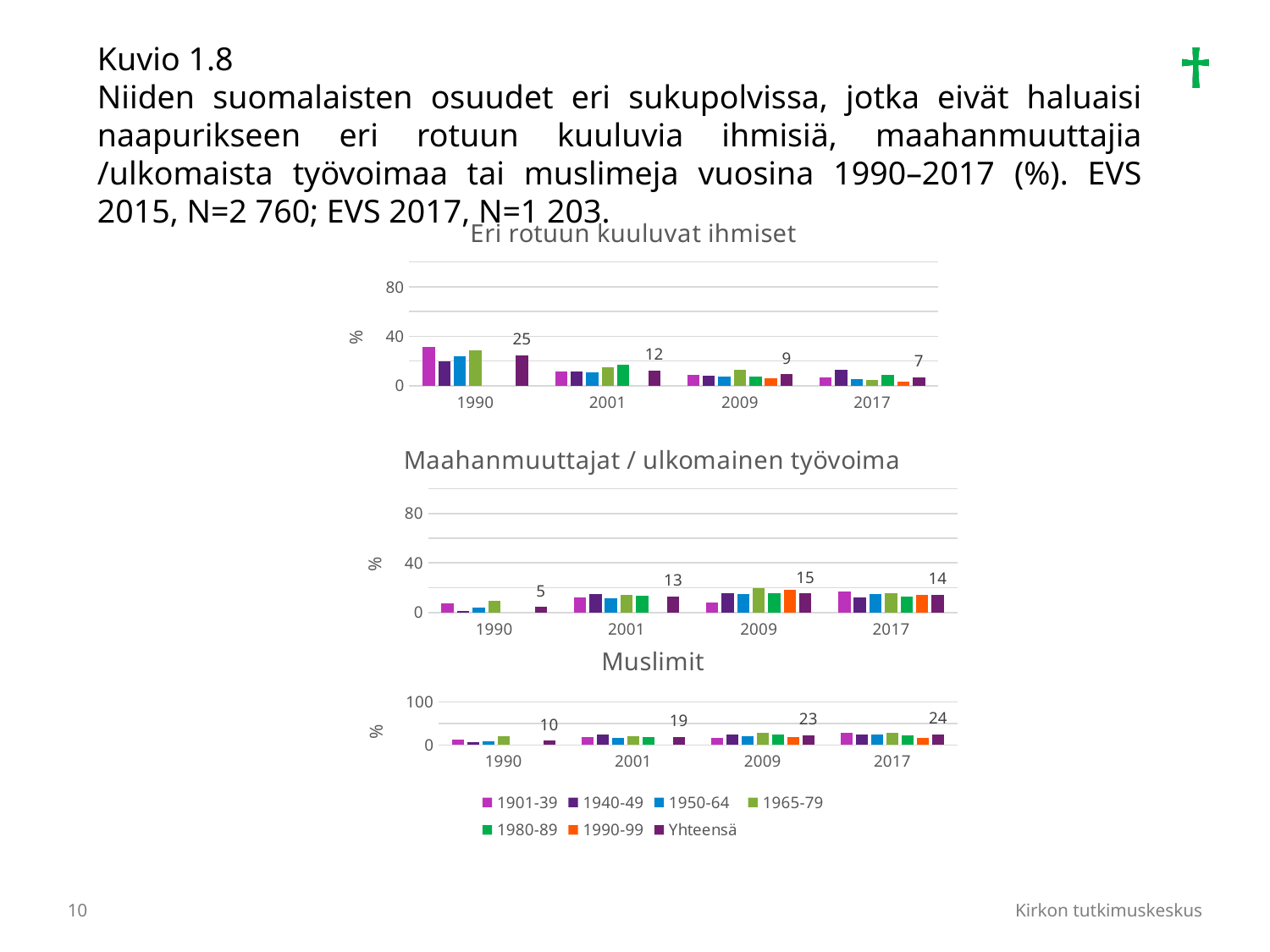
How many series does the legend at the bottom of the slide list? 7 In the chart titled "Eri rotuun kuuluvat ihmiset", do the labelled Yhteensä values rise or fall from 1990 to 2017? fall In the chart titled "Eri rotuun kuuluvat ihmiset", what is the difference between the labelled Yhteensä values for 1990 and 2001? 13 In the chart titled "Eri rotuun kuuluvat ihmiset", what is the labelled value for Yhteensä in 1990? 25 In the chart titled "Muslimit", what is the difference between the labelled Yhteensä values for 2009 and 1990? 13 In the chart titled "Eri rotuun kuuluvat ihmiset", what is the labelled value for Yhteensä in 2017? 7 In the chart titled "Maahanmuuttajat / ulkomainen työvoima", what is the labelled value for Yhteensä in 2009? 15 In the chart titled "Maahanmuuttajat / ulkomainen työvoima", which year has the lowest labelled Yhteensä value? 1990 What kind of chart is the chart titled "Muslimit"? bar chart In the chart titled "Maahanmuuttajat / ulkomainen työvoima", is the labelled Yhteensä value for 2001 or 2017 larger? 2017 In the chart titled "Muslimit", what is the labelled value for Yhteensä in 2017? 24 In the chart titled "Muslimit", which year has the highest labelled Yhteensä value? 2017